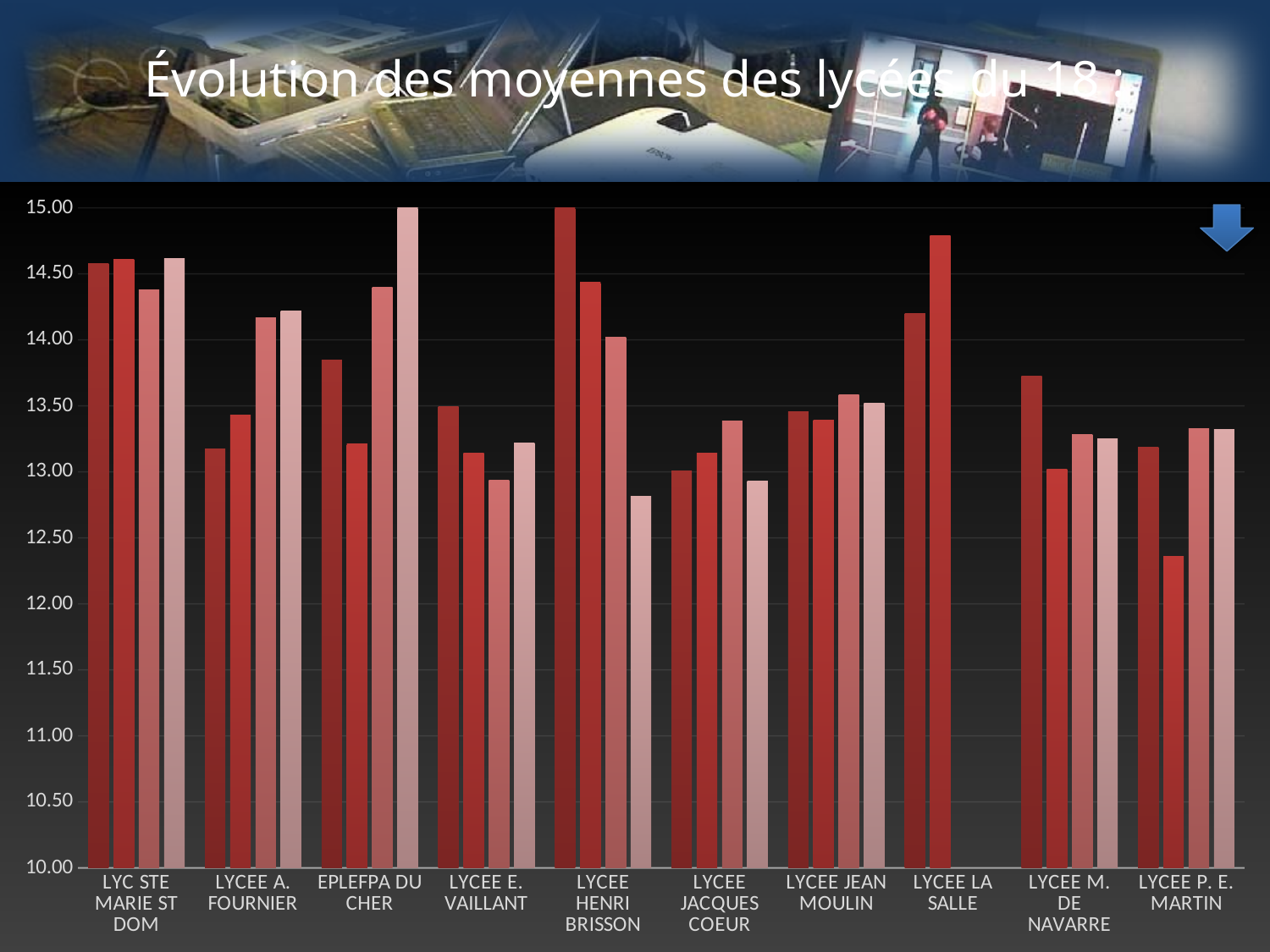
Is the fourth (rightmost) bar for LYCEE HENRI BRISSON greater or less than 13.00? less Is the second bar for LYCEE LA SALLE greater or less than 14.50? greater How many lycées (categories) are shown along the x axis? 10 Which is larger: the first bar for LYCEE LA SALLE or the first bar for LYCEE JEAN MOULIN? LYCEE LA SALLE What is the title of the chart on the slide? Évolution des moyennes des lycées du 18 : Which is larger: the first bar for LYC STE MARIE ST DOM or the first bar for LYCEE A. FOURNIER? LYC STE MARIE ST DOM Which lycée has the single lowest bar on the chart? LYCEE P. E. MARTIN Is the first bar for LYCEE A. FOURNIER greater or less than 13.00? greater How many bars are shown for LYCEE LA SALLE? 2 What kind of chart is shown on the slide? bar chart